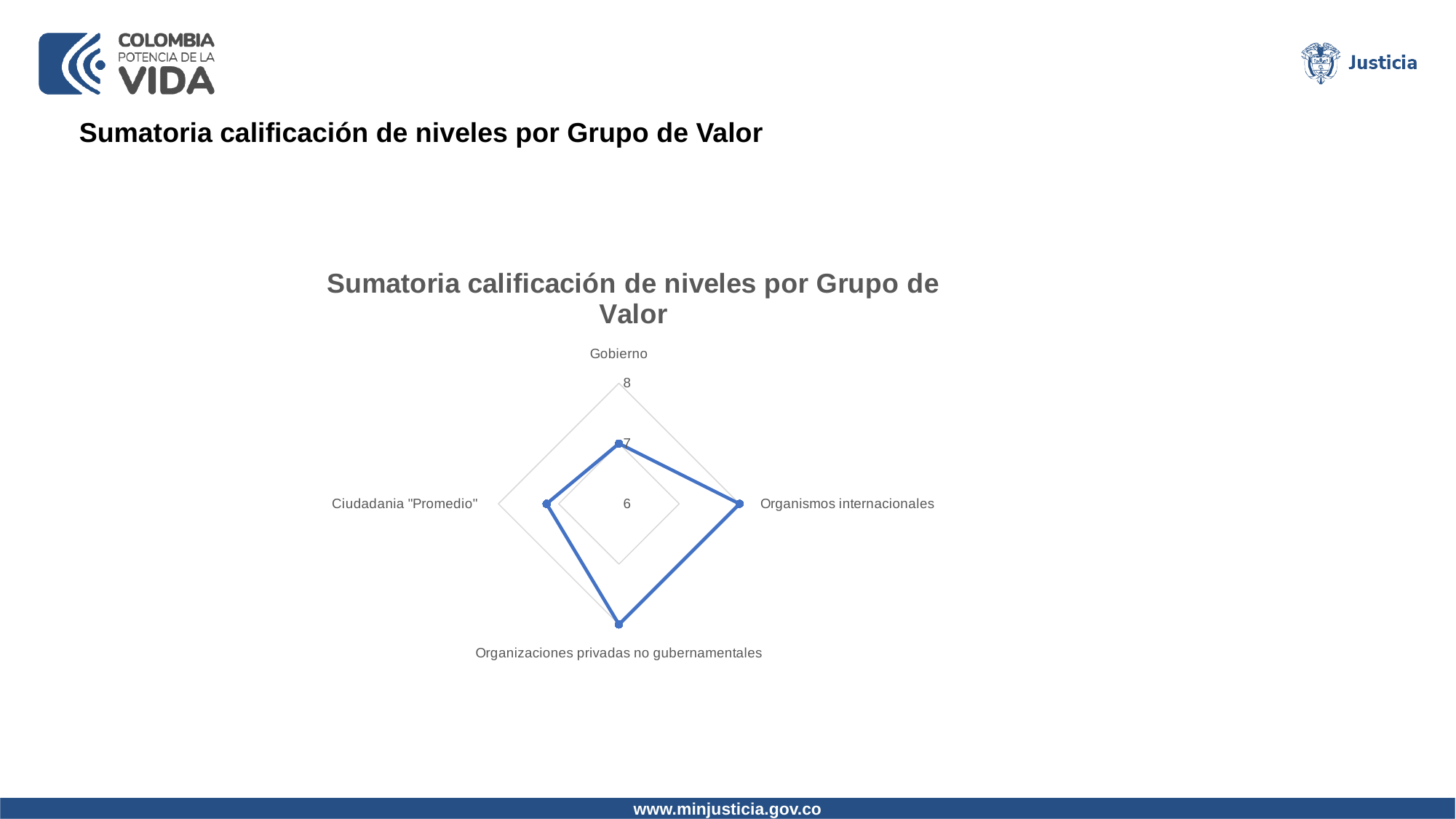
How many categories (axes) does the radar chart have? 4 What is the title of the chart? Sumatoria calificación de niveles por Grupo de Valor What is the value for Organismos internacionales? 8 What is the highest value shown on the chart's axis scale? 8 What is the value for Organizaciones privadas no gubernamentales? 8 What kind of chart is shown on the slide? Radar chart What is the value for Gobierno? 7 Is the value for Ciudadania "Promedio" greater or less than 8? less Which is larger, the value for Organismos internacionales or the value for Gobierno? Organismos internacionales What is the difference between the value for Organismos internacionales and the value for Gobierno? 1 Is the value for Organismos internacionales greater or less than 7? greater Which is larger, the value for Organizaciones privadas no gubernamentales or the value for Ciudadania "Promedio"? Organizaciones privadas no gubernamentales